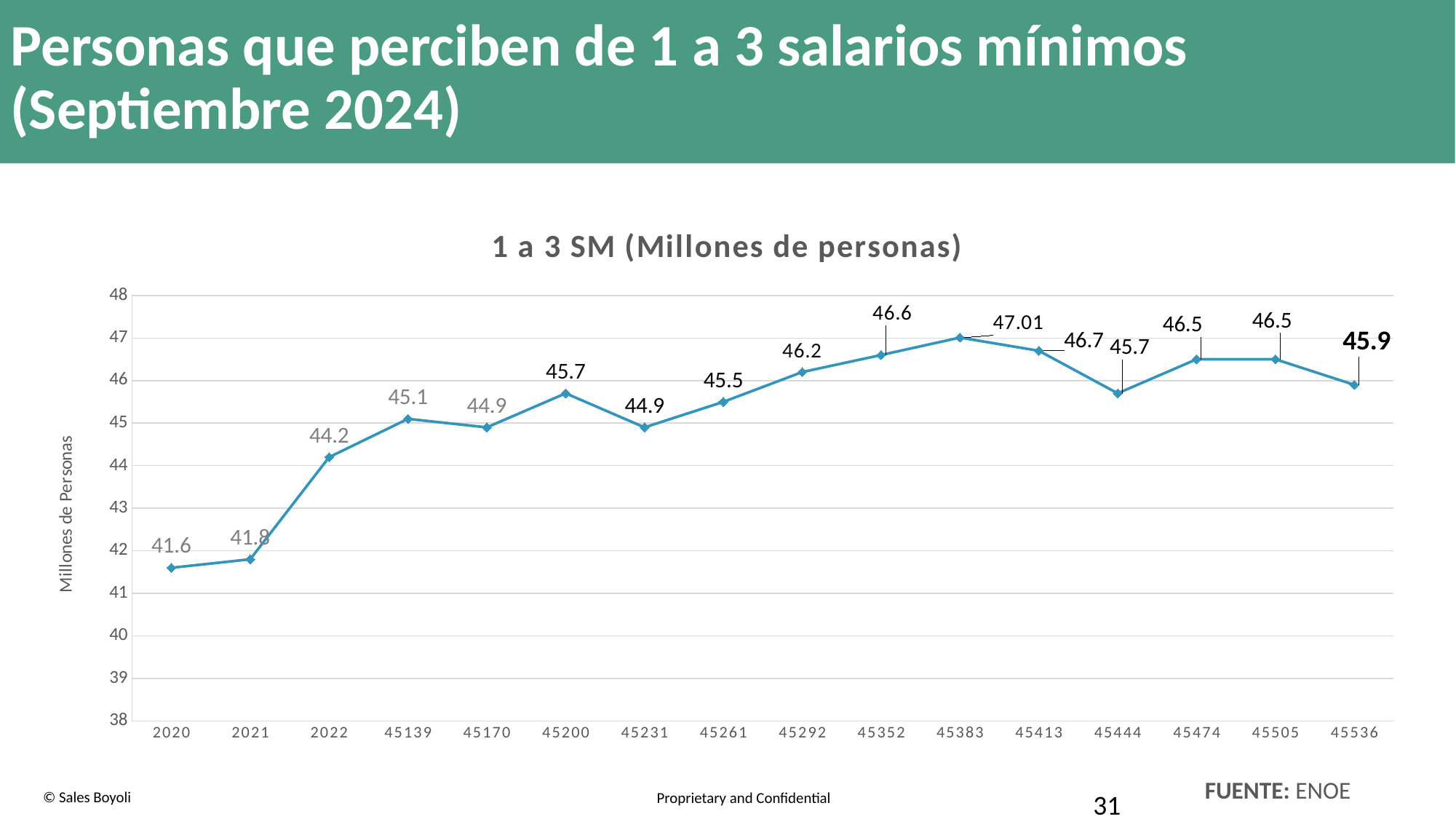
What is the label of the vertical axis? Millones de Personas What is the value for 2022? 44.2 What is the value for 45383? 47.01 Which is larger, the value for 45413 or the value for 45444? 45413 What is the title of the chart? 1 a 3 SM (Millones de personas) What is the difference between the values for 2022 and 2021? 2.4 What is the value for 2020? 41.6 What type of chart is shown on the slide? line chart How many data points are plotted on the line? 16 Which x-axis category has the lowest value? 2020 Which x-axis category has the highest value? 45383 What is the value for 45536? 45.9